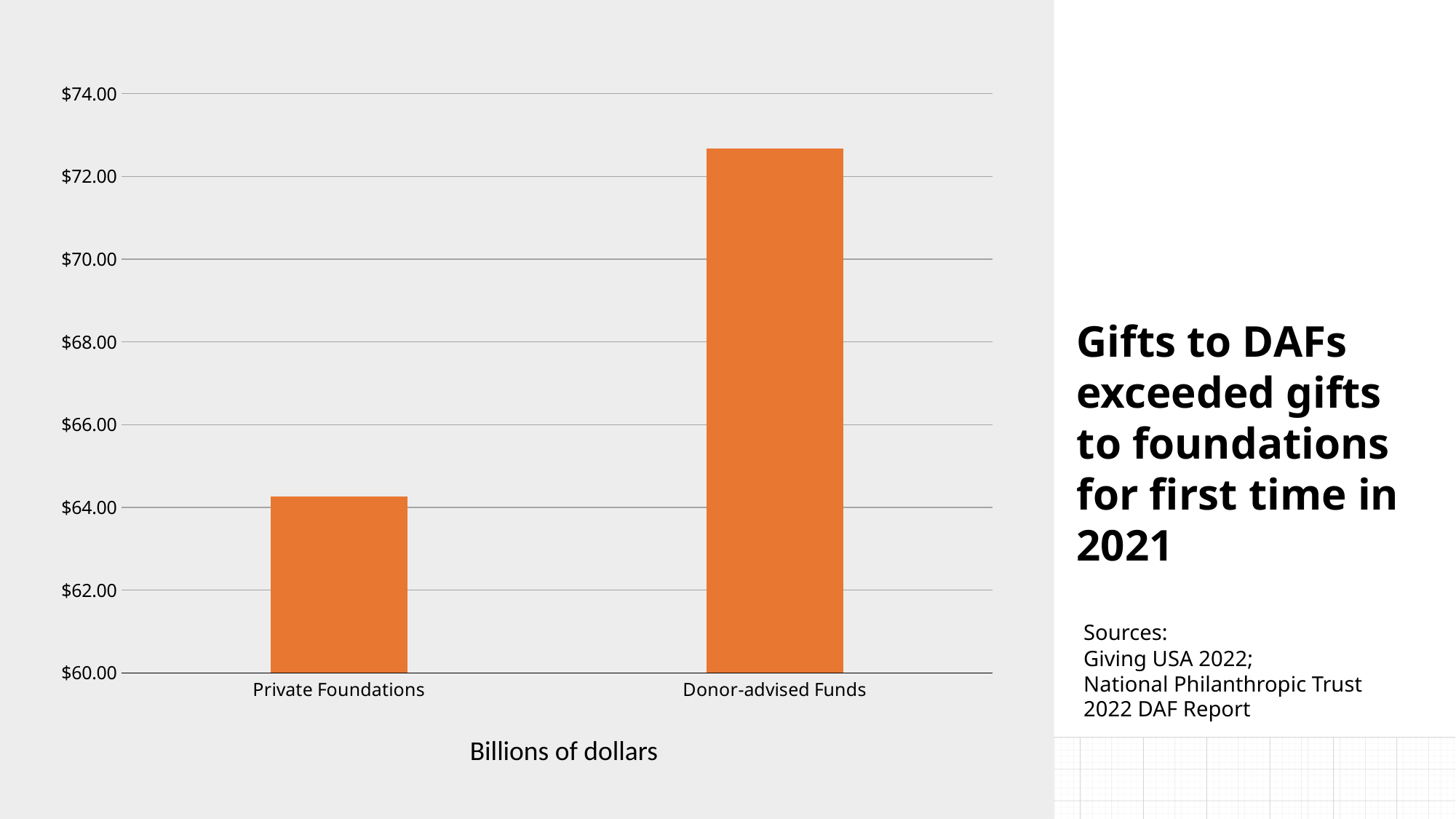
Is the value for Private Foundations greater or less than $64.00? greater Which category has the highest value in the chart? Donor-advised Funds How many categories are plotted in the chart? 2 Is the value for Donor-advised Funds greater or less than $74.00? less What unit is given in the label below the chart's x axis? Billions of dollars Is the value for Donor-advised Funds greater or less than $72.00? greater Which category has the lowest value in the chart? Private Foundations What kind of chart is shown on the slide? bar chart What colour are the bars in the chart? orange Which is larger, the value for Private Foundations or the value for Donor-advised Funds? Donor-advised Funds